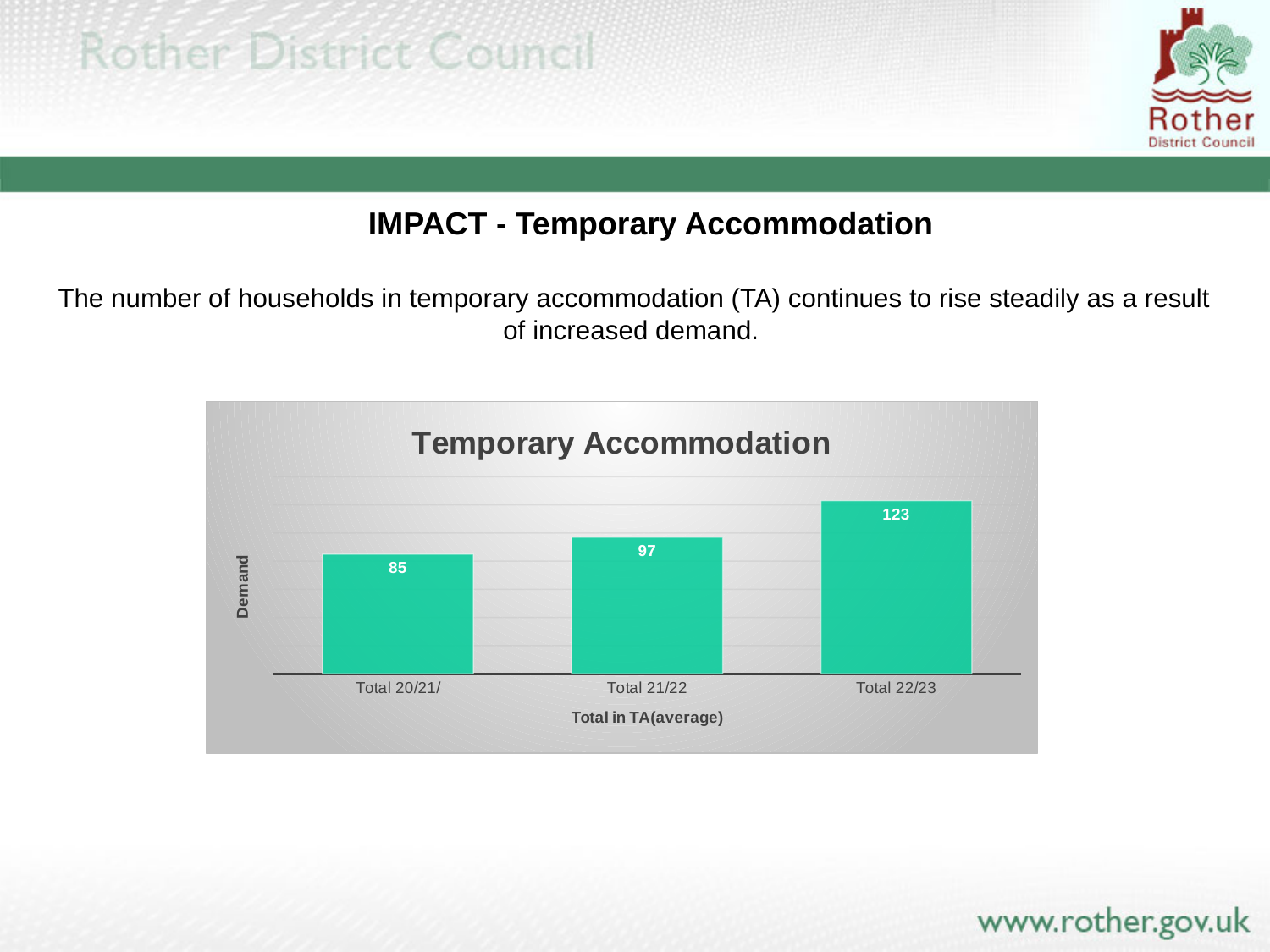
Which is larger, the value for Total 21/22 or the value for Total 22/23? Total 22/23 Which category has the lowest value in the Temporary Accommodation chart? Total 20/21/ What is the difference between the values for Total 21/22 and Total 20/21/? 12 What is the value for Total 21/22 in the Temporary Accommodation chart? 97 Which category has the highest value in the Temporary Accommodation chart? Total 22/23 What is the difference between the values for Total 22/23 and Total 20/21/? 38 What is the value for Total 22/23 in the Temporary Accommodation chart? 123 How many categories are shown in the Temporary Accommodation chart? 3 Do the values rise or fall from Total 20/21/ to Total 22/23? Rise What is the value for Total 20/21/ in the Temporary Accommodation chart? 85 What kind of chart is the Temporary Accommodation chart? Bar chart What is the label on the vertical axis of the Temporary Accommodation chart? Demand